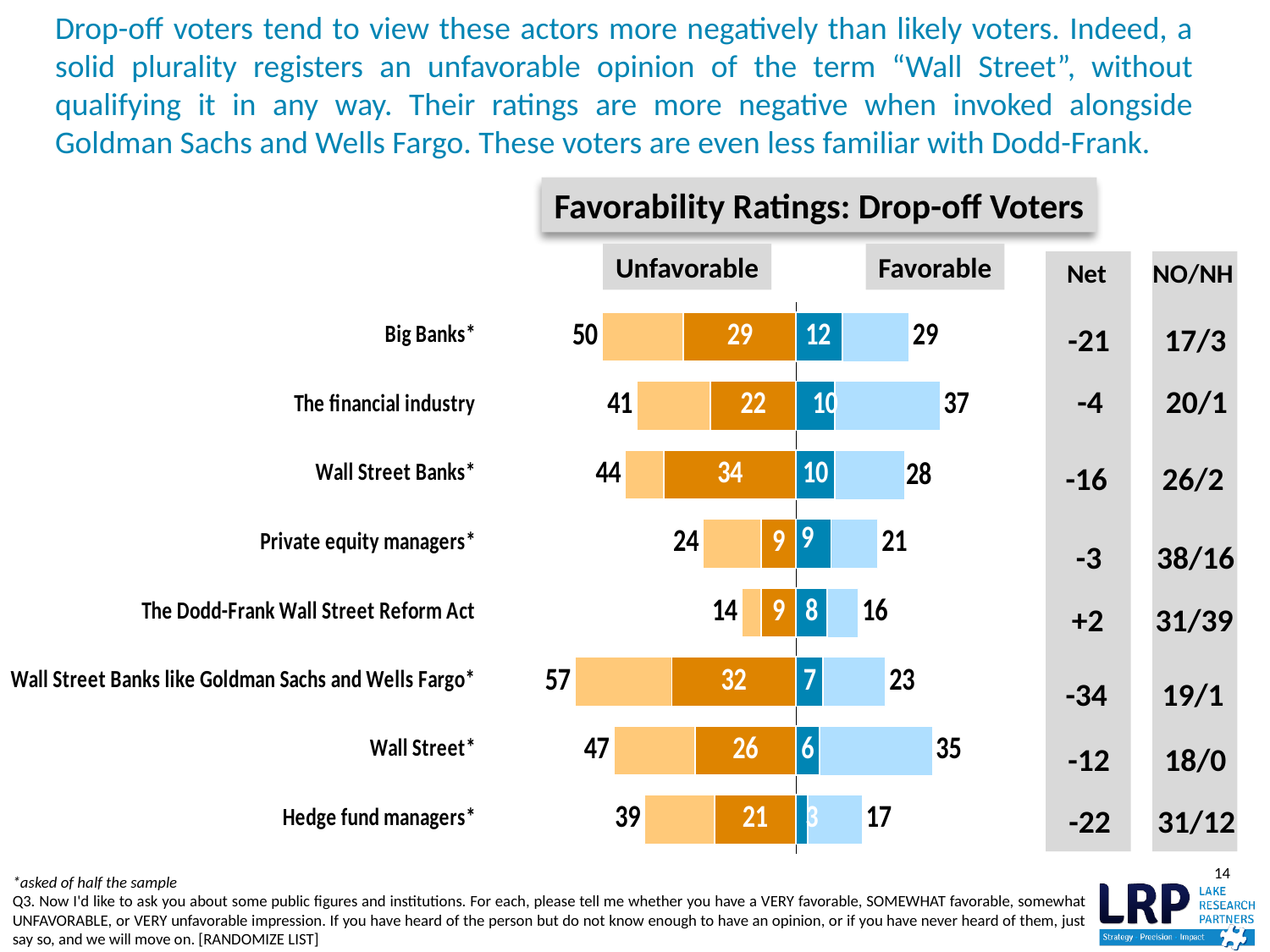
Which category has the highest total unfavorable rating? Wall Street Banks like Goldman Sachs and Wells Fargo What is the total unfavorable rating for Big Banks? 50 What type of chart is shown on the slide? Bar chart What is the very unfavorable (dark orange) value for Wall Street Banks like Goldman Sachs and Wells Fargo? 32 What is the title of the chart? Favorability Ratings: Drop-off Voters Which has a higher total unfavorable rating, Wall Street Banks or The financial industry? Wall Street Banks What is the total favorable rating for The Dodd-Frank Wall Street Reform Act? 16 Which category has the lowest total unfavorable rating? The Dodd-Frank Wall Street Reform Act What is the total favorable rating for Wall Street? 35 What is the difference between the total unfavorable and total favorable ratings for Big Banks? 21 Which category has the highest total favorable rating? The financial industry How many categories are shown in the chart? 8